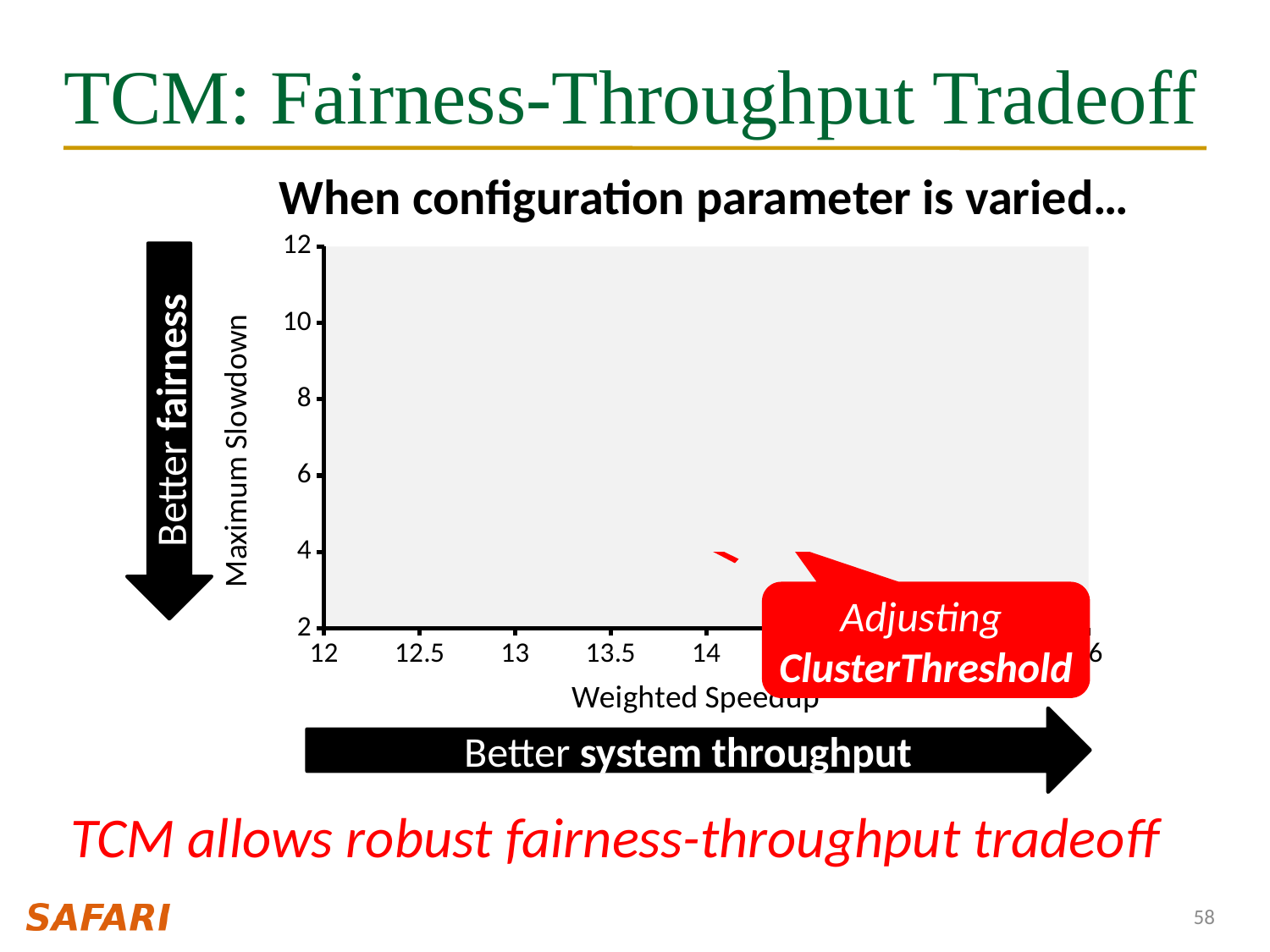
Is the Maximum Slowdown of the visible red data point greater or less than 6? less Is the Weighted Speedup of the visible red data point greater or less than 13? greater What is the title of the chart? When configuration parameter is varied… What is the label of the chart's y axis? Maximum Slowdown